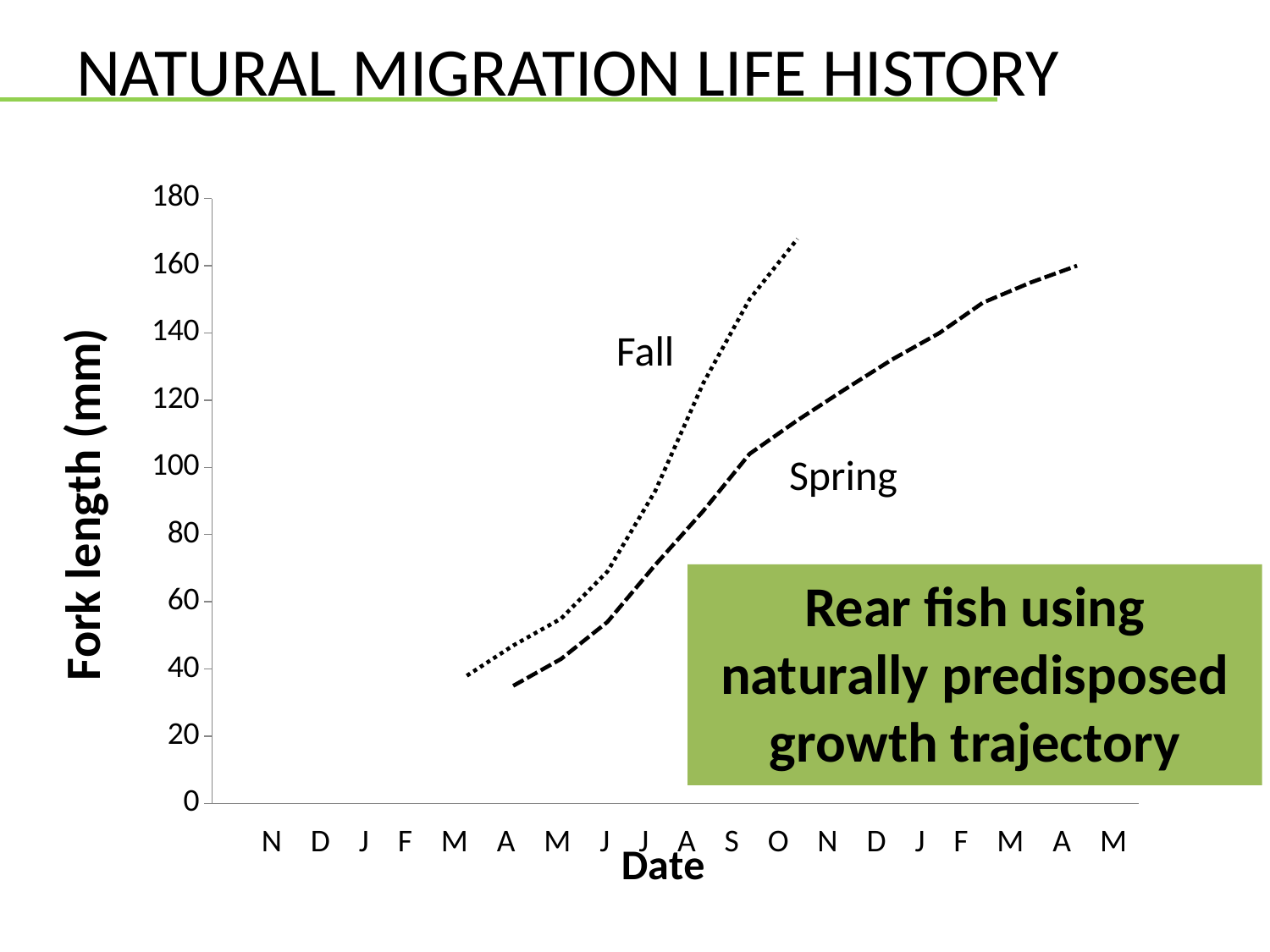
Does the Fall line rise or fall as the date advances along the x axis? rise What kind of chart is shown on the slide? line chart How many month labels are shown along the x axis? 19 Is the highest fork length reached by the Spring line greater or less than 140? greater Is the highest fork length reached by the Fall line greater or less than 160? greater Is the fork length at the start of the Fall line greater or less than 60? less Which series reaches the higher maximum fork length, Fall or Spring? Fall Does the Spring line rise or fall as the date advances along the x axis? rise What is the title of the y axis? Fork length (mm) How many series are plotted on the chart? 2